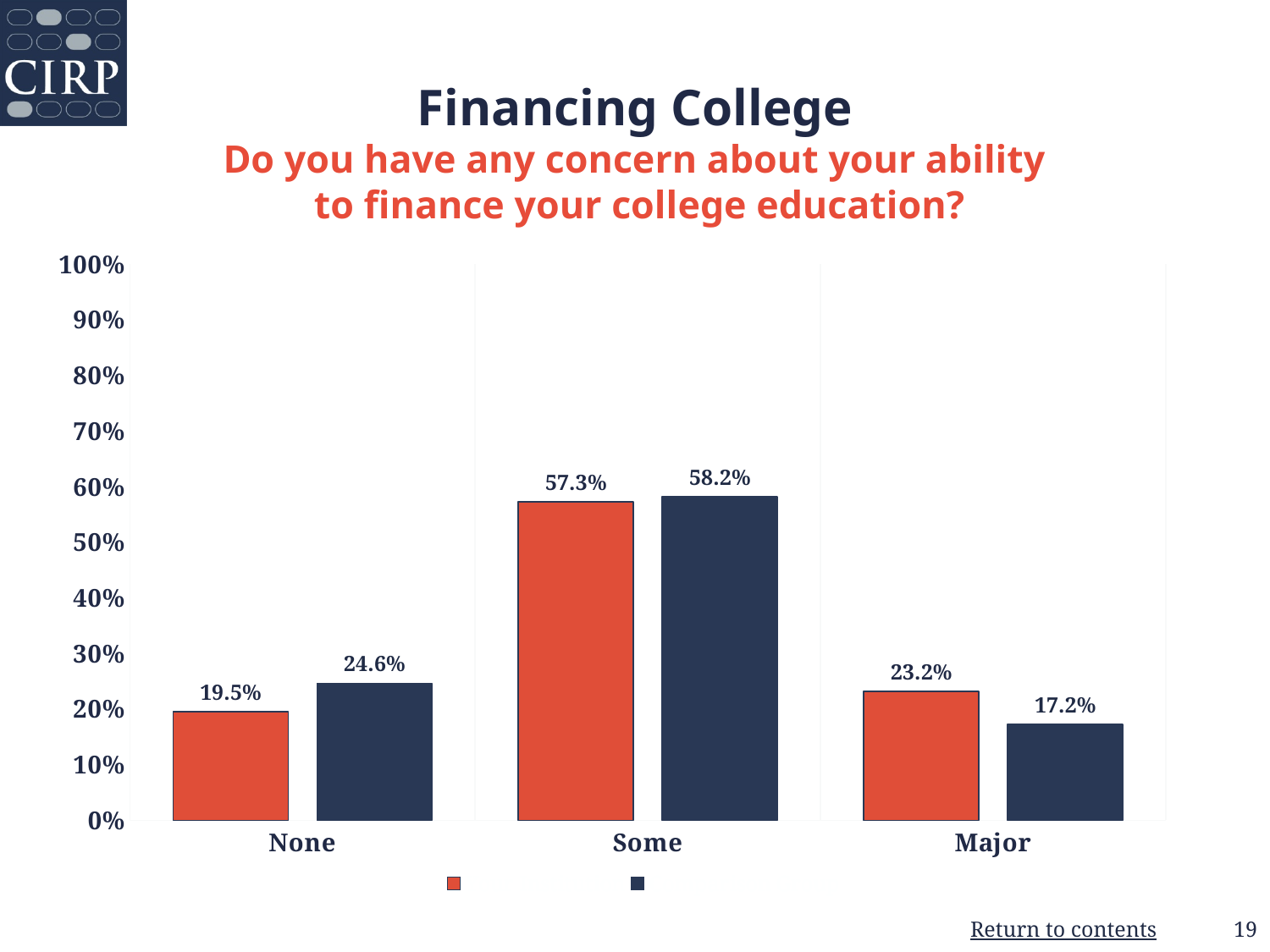
What is the difference between the dark blue bar and the orange bar for the "None" category? 5.1% Which category has the lowest value for the orange series? None Is the value of the orange bar for "Some" greater or less than 50%? greater What is the value of the dark blue bar for the "Major" category? 17.2% What is the value of the orange bar for the "Some" category? 57.3% How many series does the legend show? 2 What is the value of the dark blue bar for the "None" category? 24.6% Which category has the highest value for the dark blue series? Some How many categories are shown on the x axis? 3 For the "Major" category, which bar is larger, the orange bar or the dark blue bar? the orange bar What is the value of the orange bar for the "Major" category? 23.2% What kind of chart is shown on the slide? bar chart